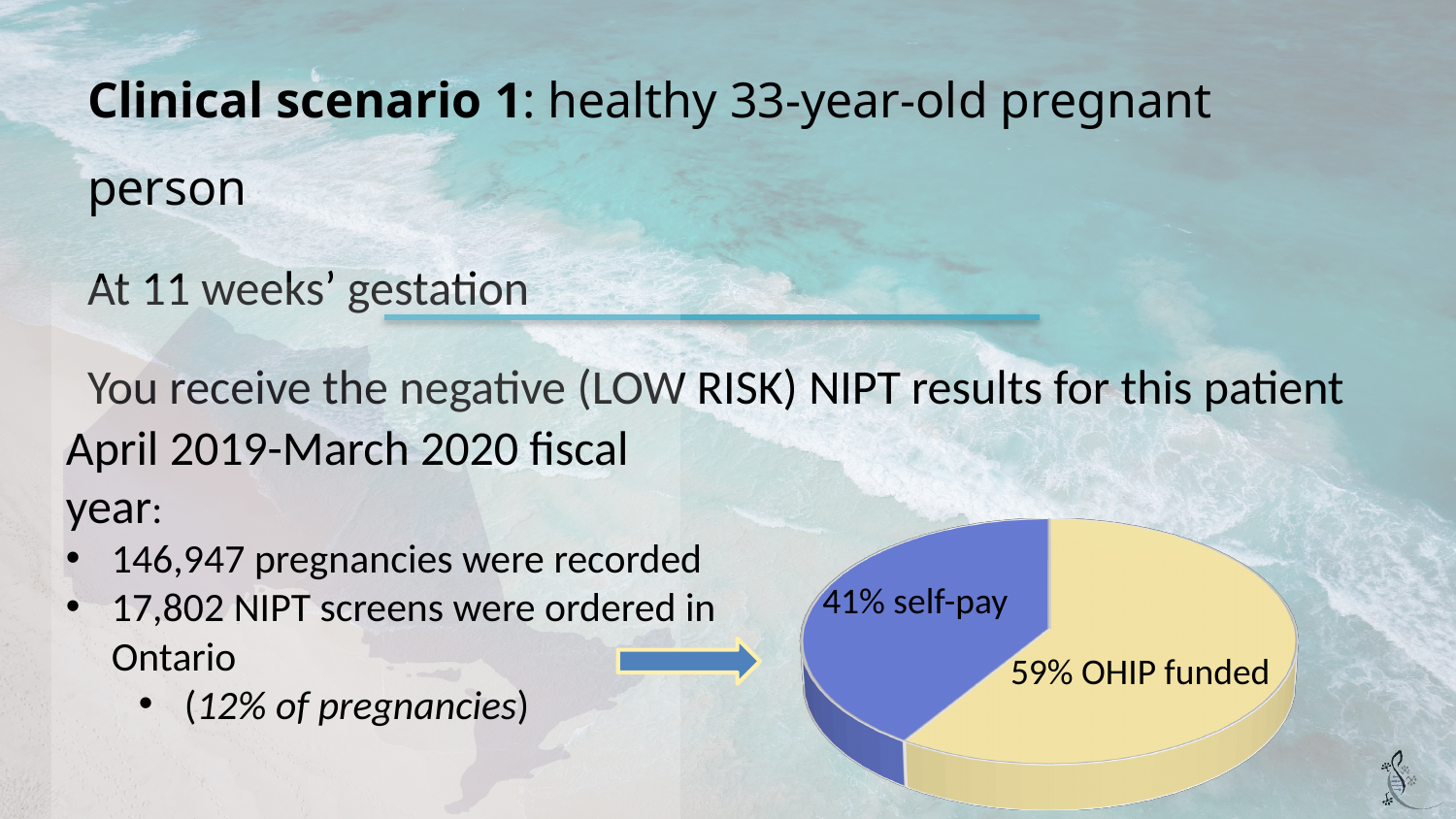
What is the difference in percentage points between the OHIP funded and self-pay slices? 18 What share of the pie is labelled self-pay? 41% What colour is the OHIP funded slice of the pie? yellow What kind of chart is shown on the slide? pie chart Which slice of the pie is the largest? OHIP funded What colour is the self-pay slice of the pie? blue Which slice of the pie is the smallest? self-pay What share of the pie is labelled OHIP funded? 59% Which slice of the pie is larger, self-pay or OHIP funded? OHIP funded How many slices does the pie chart have? 2